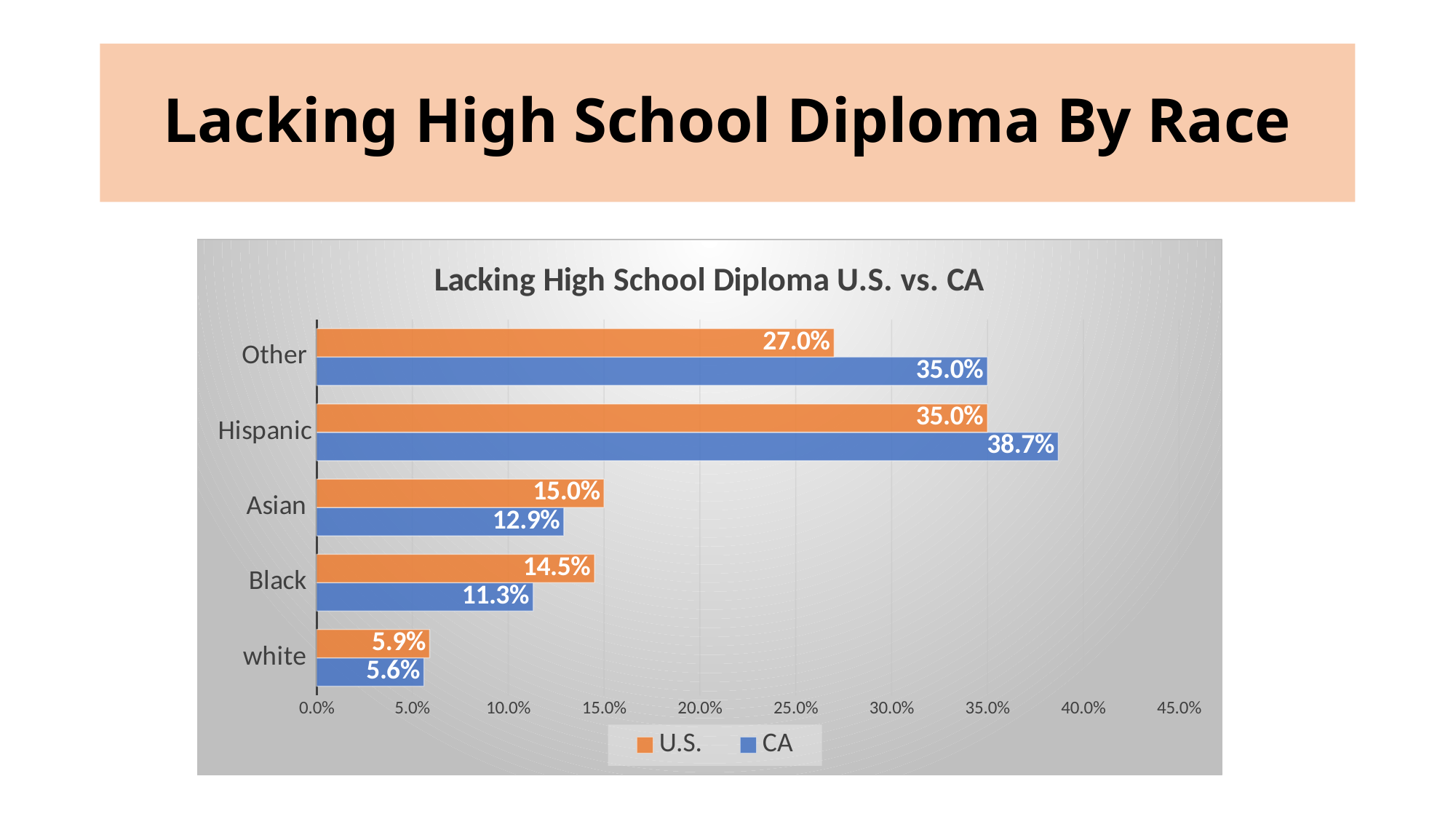
What is the CA value for Asian? 12.9% Which category has the highest CA value? Hispanic How many race categories are shown on the chart? 5 What is the title of the chart? Lacking High School Diploma U.S. vs. CA What kind of chart is shown on the slide? bar chart How many series does the legend list? 2 What is the difference between the CA and U.S. values for Other? 8.0% Is the CA value for Hispanic greater or less than 35.0%? greater Which is larger for Black, the U.S. value or the CA value? U.S. What is the U.S. value for Hispanic? 35.0% What is the CA value for Black? 11.3% Which category has the lowest U.S. value? white